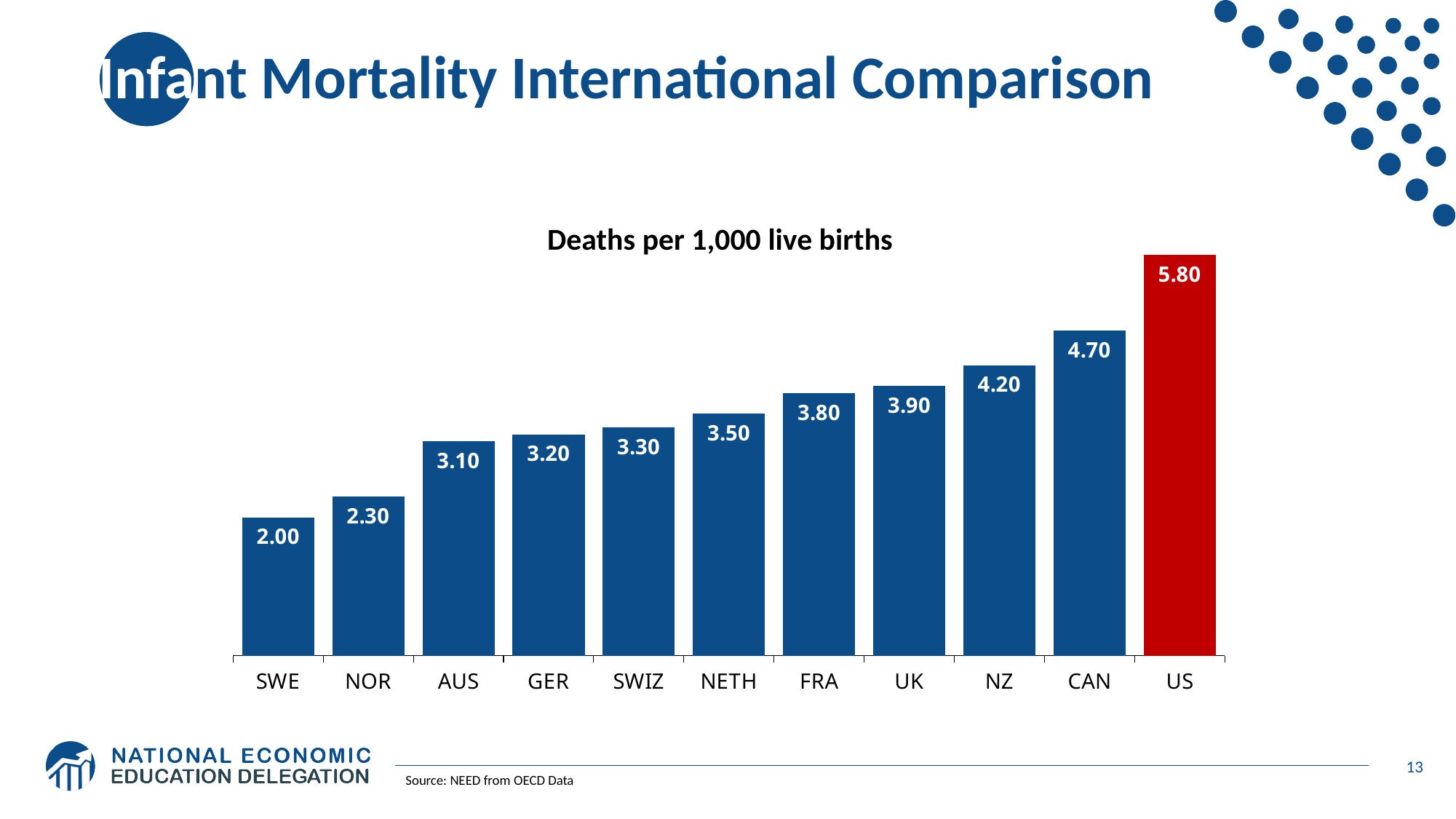
How many countries are shown in the chart? 11 What is the value for FRA? 3.80 What is the value for SWE? 2.00 Do the values rise or fall from left to right along the x axis? Rise What is the difference between the values for UK and SWE? 1.90 Which country has the lowest value? SWE What kind of chart is shown on the slide? Bar chart What is the value for the US? 5.80 Which country has the highest value? US What is the difference between the values for the US and CAN? 1.10 What is the title of the chart? Deaths per 1,000 live births Which is larger, the value for NZ or the value for NETH? NZ